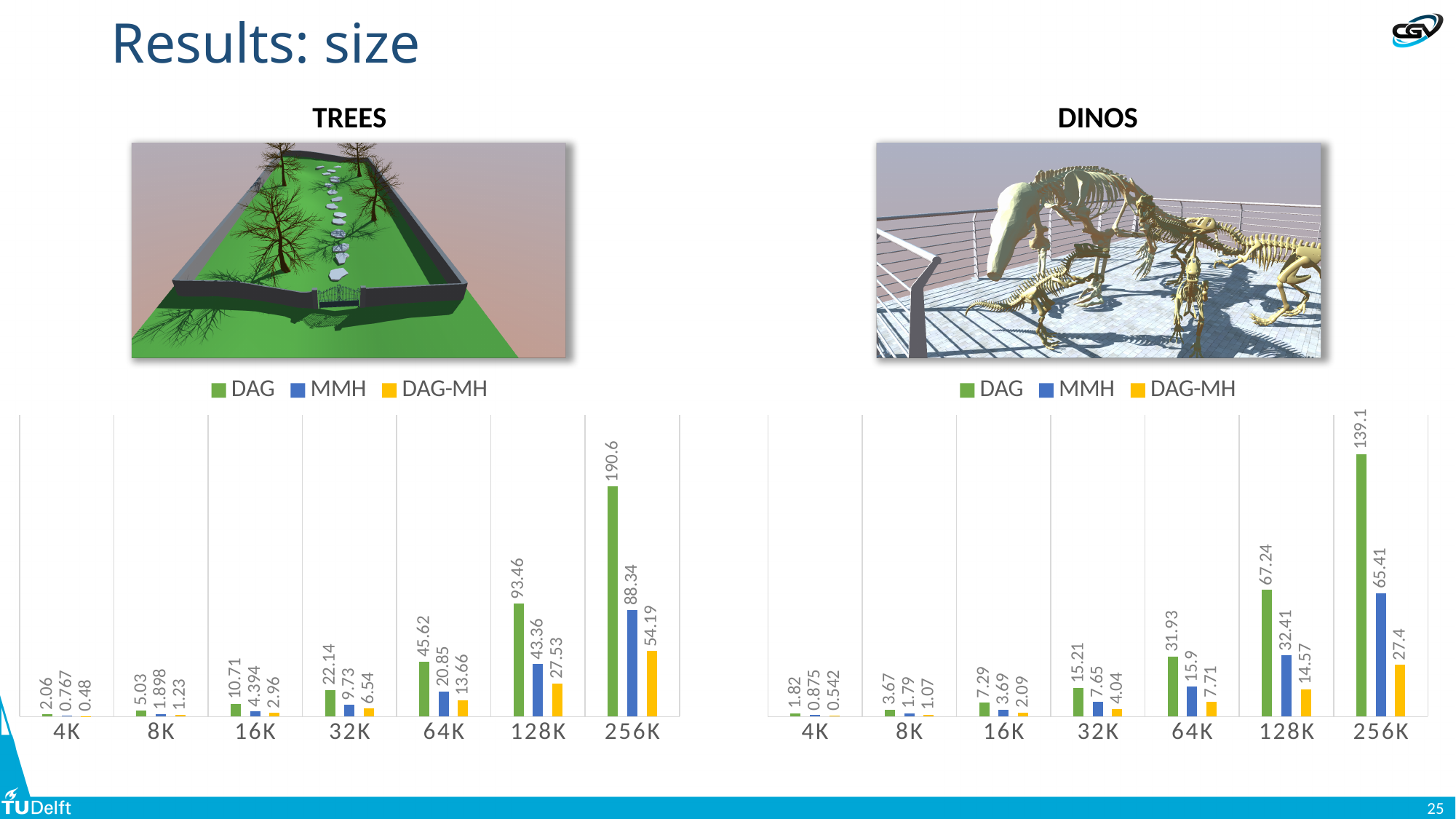
In the DINOS chart, what is the DAG-MH value at 256K? 27.4 Which is larger: the DAG value at 256K in the TREES chart or the DAG value at 256K in the DINOS chart? TREES In the TREES chart, what is the DAG value at 256K? 190.6 In the DINOS chart, what is the difference between the MMH and DAG-MH values at 64K? 8.19 In the DINOS chart, what is the MMH value at 128K? 32.41 In the TREES chart, which series has the highest value at 128K? DAG In the DINOS chart, which series has the lowest value at 32K? DAG-MH What type of chart is used for the DINOS results? Bar chart In the TREES chart, what is the difference between the DAG and MMH values at 256K? 102.26 In the TREES chart, what is the DAG-MH value at 64K? 13.66 How many series does the legend of the DINOS chart list? 3 How many size categories are shown on the x axis of the TREES chart? 7